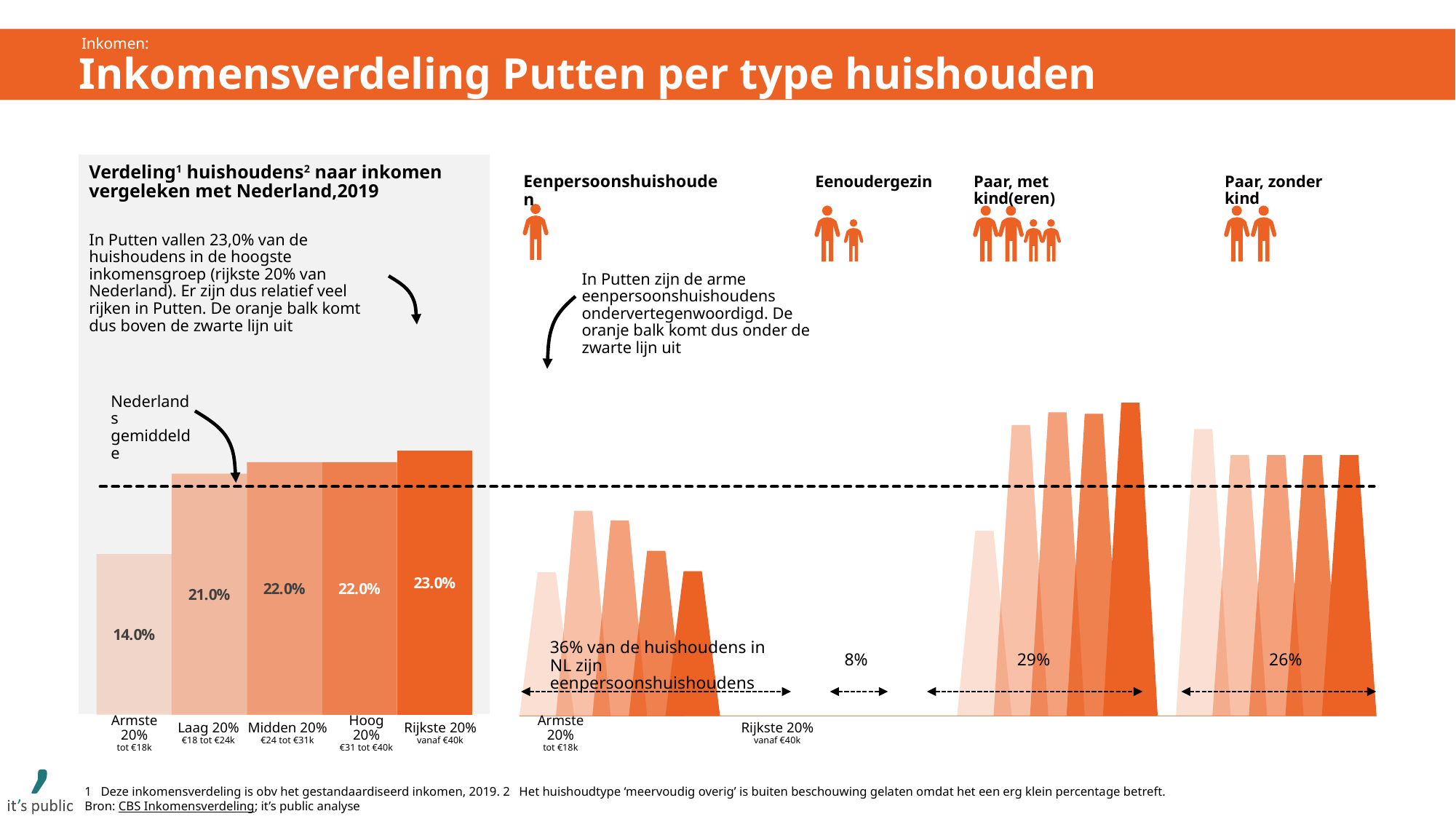
In the left chart 'Verdeling huishoudens naar inkomen vergeleken met Nederland, 2019', what is the difference between the Rijkste 20% and Armste 20% values? 9.0% In the left chart 'Verdeling huishoudens naar inkomen vergeleken met Nederland, 2019', how many income groups are shown? 5 In the left chart 'Verdeling huishoudens naar inkomen vergeleken met Nederland, 2019', which is larger: the value for Laag 20% or the value for Rijkste 20%? Rijkste 20% In the left chart 'Verdeling huishoudens naar inkomen vergeleken met Nederland, 2019', do the values rise or fall from Armste 20% to Rijkste 20%? Rise On the right-hand chart, what share of households in NL are eenpersoonshuishoudens? 36% What does the dashed horizontal line in the left chart represent? Nederlands gemiddelde In the left chart 'Verdeling huishoudens naar inkomen vergeleken met Nederland, 2019', what is the value for Armste 20%? 14.0% What kind of chart is the left chart 'Verdeling huishoudens naar inkomen vergeleken met Nederland, 2019'? Bar chart In the left chart 'Verdeling huishoudens naar inkomen vergeleken met Nederland, 2019', which income group has the lowest value? Armste 20% In the left chart 'Verdeling huishoudens naar inkomen vergeleken met Nederland, 2019', what is the value for Laag 20%? 21.0% In the left chart 'Verdeling huishoudens naar inkomen vergeleken met Nederland, 2019', which income group has the highest value? Rijkste 20% In the left chart 'Verdeling huishoudens naar inkomen vergeleken met Nederland, 2019', what is the value for Rijkste 20%? 23.0%